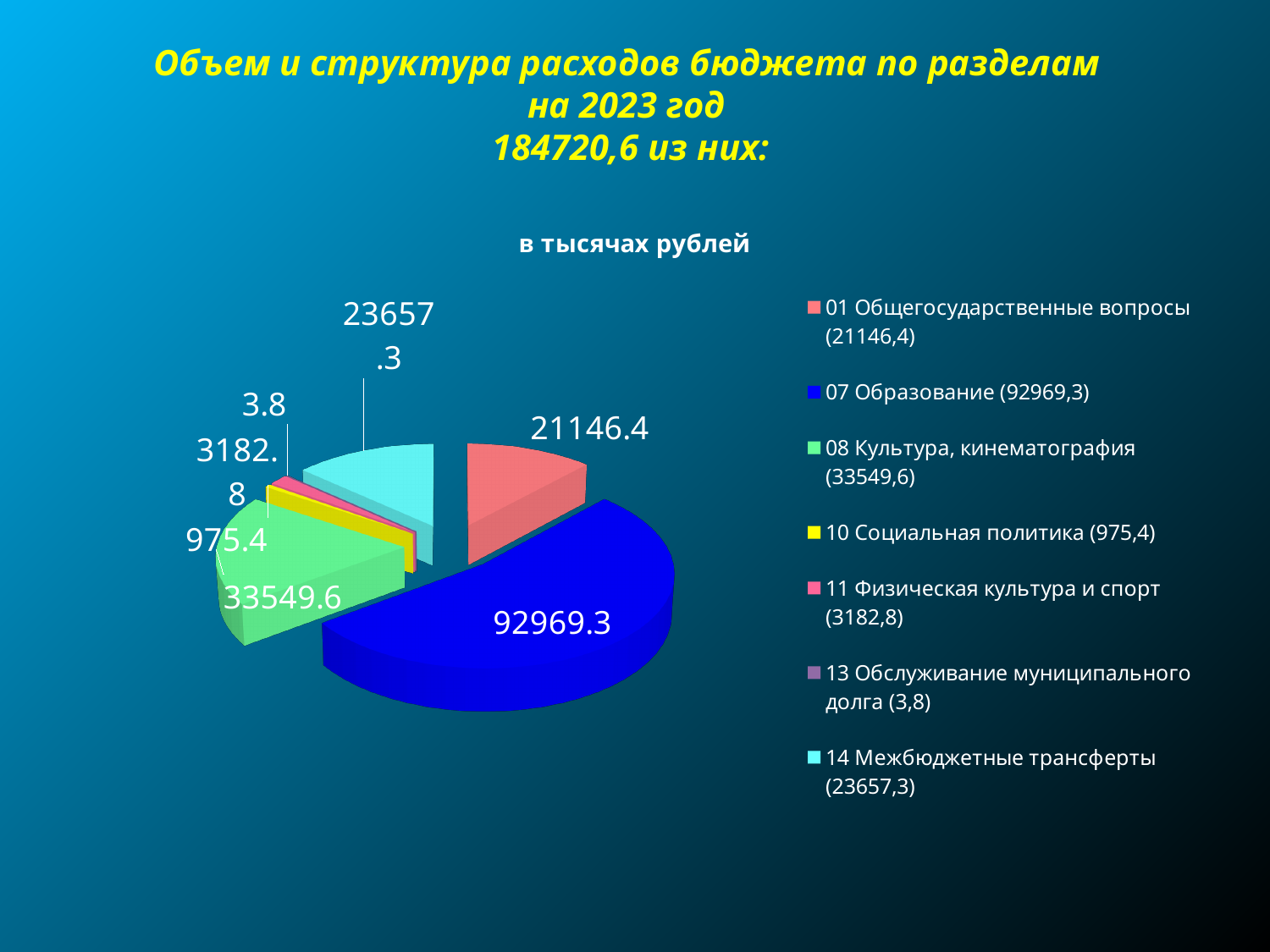
What is the title of the chart? в тысячах рублей How many categories does the pie chart have? 7 What is the value for 14 Межбюджетные трансферты? 23657.3 What is the difference between the values for 07 Образование and 08 Культура, кинематография? 59419.7 What is the value for 08 Культура, кинематография? 33549.6 What is the value for 10 Социальная политика? 975.4 What kind of chart is shown on the slide? pie chart Which is larger, the value for 11 Физическая культура и спорт or the value for 10 Социальная политика? 11 Физическая культура и спорт Which category has the largest slice of the pie? 07 Образование What is the value for 07 Образование? 92969.3 Which category has the smallest slice of the pie? 13 Обслуживание муниципального долга What is the difference between the values for 14 Межбюджетные трансферты and 01 Общегосударственные вопросы? 2510.9